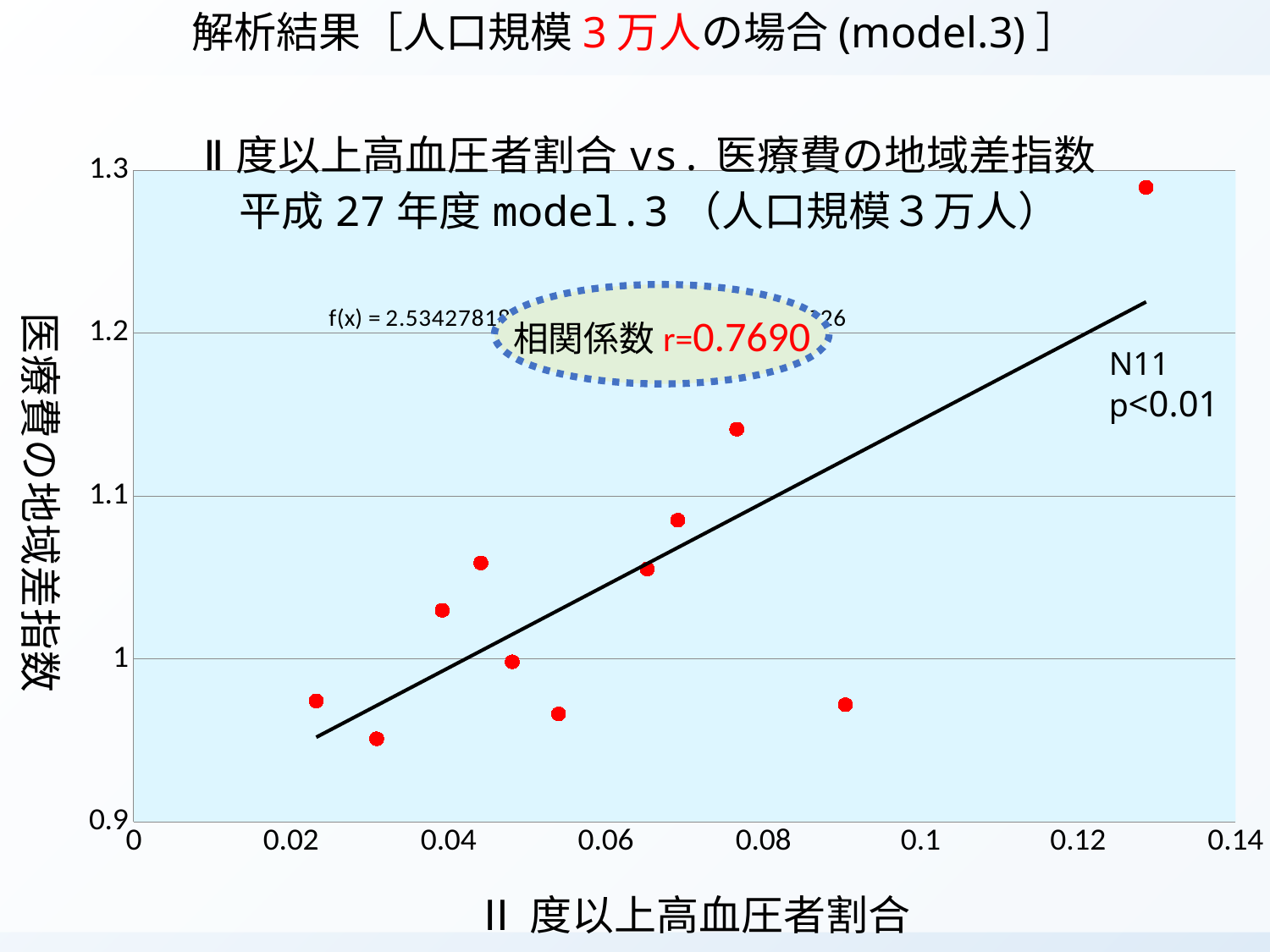
What correlation coefficient (r) is shown on the chart? r=0.7690 Is the y value of the lowest data point greater or less than 1? less Is the y value of the data point near x = 0.09 greater or less than 1? less How many data points are plotted in the chart? 11 Is the y value of the highest data point greater or less than 1.2? greater What p-value is shown on the chart? p<0.01 What kind of chart is shown on the slide? scatter plot Which has the larger y value: the data point near x = 0.077 or the data point near x = 0.09? the data point near x = 0.077 Do the values of the fitted line rise or fall as the x axis increases? rise What is the label of the x axis? Ⅱ度以上高血圧者割合